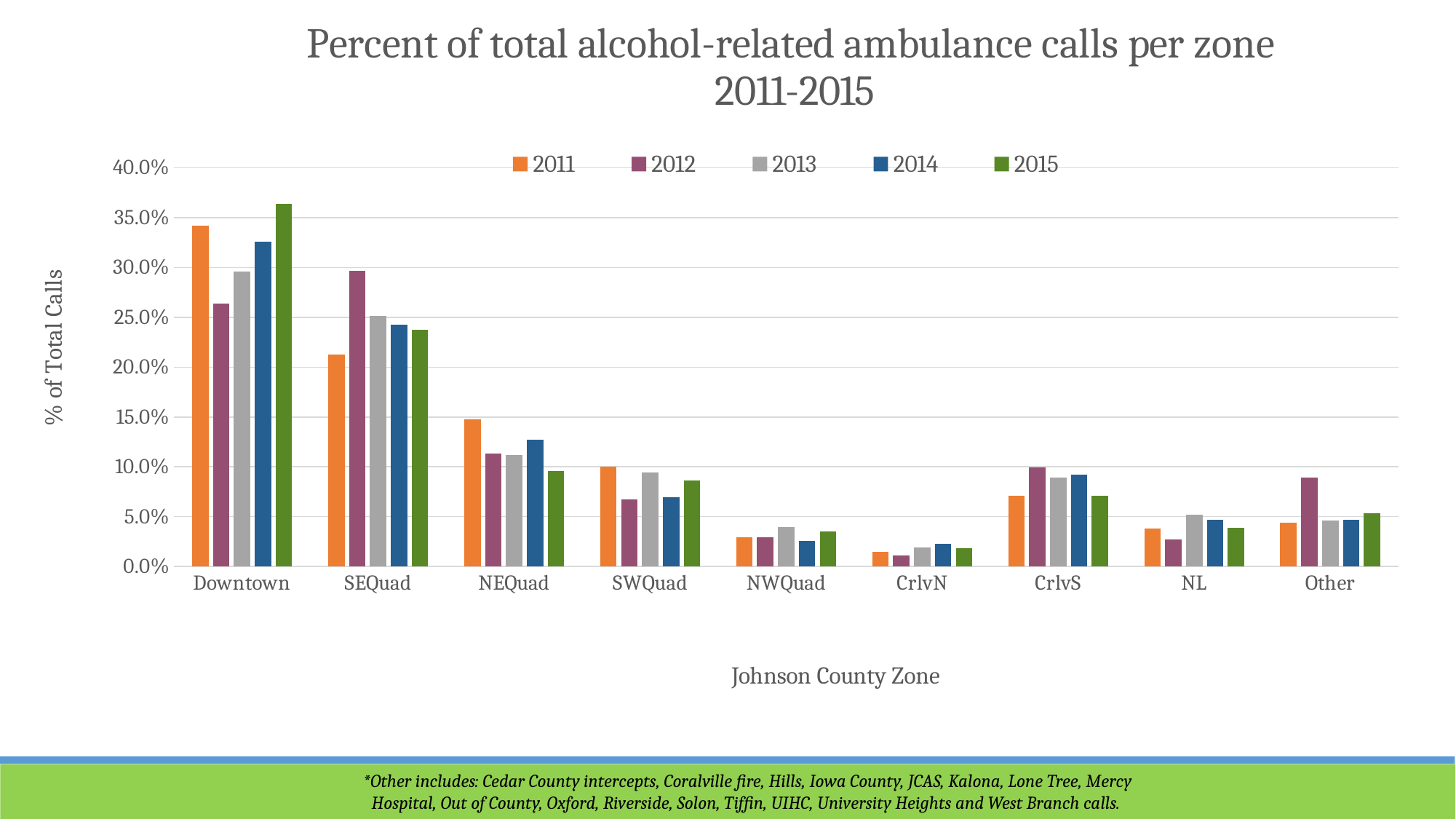
How many zones are shown on the x axis? 9 Do the SEQuad values rise or fall from 2012 to 2015? fall How many series does the legend list? 5 For Other, which is larger: the 2011 value or the 2012 value? 2012 Which zone has the lowest value for 2012? CrlvN Is the value for NEQuad in 2011 greater or less than 10.0%? greater For Downtown, which is larger: the 2011 value or the 2012 value? 2011 Is the value for SEQuad in 2012 greater or less than 25.0%? greater Which zone has the highest value for 2015? Downtown Is the value for Downtown in 2011 greater or less than 30.0%? greater What kind of chart is shown on the slide? Bar chart What is the title of the x axis? Johnson County Zone